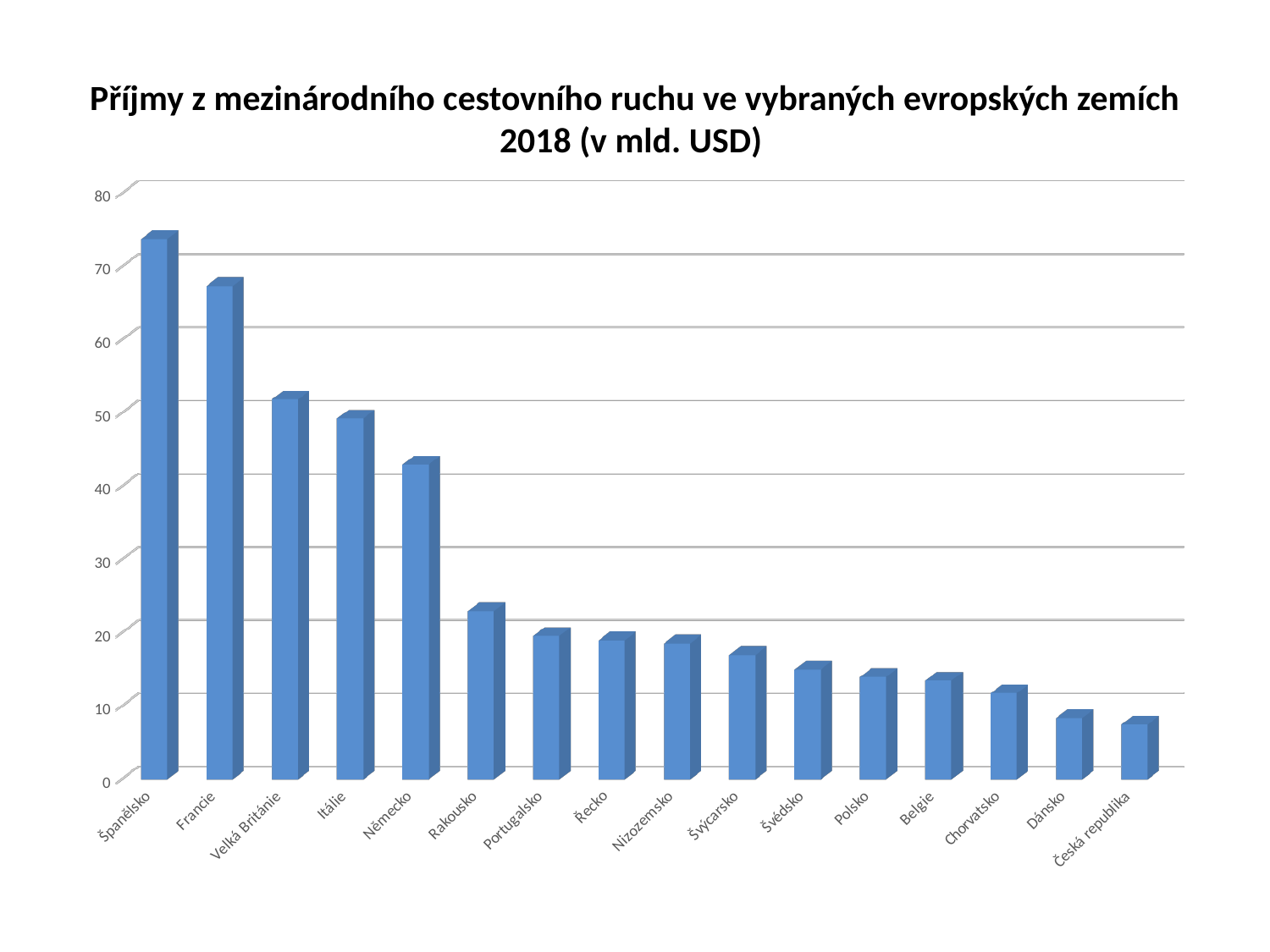
Is the value for Španělsko greater or less than 70? greater What unit is given in the chart title for the values? mld. USD Do the values rise or fall from left to right along the x axis? fall Which country has the lowest value in the chart? Česká republika Is the value for Rakousko greater or less than 20? greater Is the value for Německo greater or less than 40? greater Which country has the highest value in the chart? Španělsko How many countries are shown on the x axis of the chart? 16 Which has a larger value, Velká Británie or Itálie? Velká Británie What kind of chart is shown on the slide? bar chart